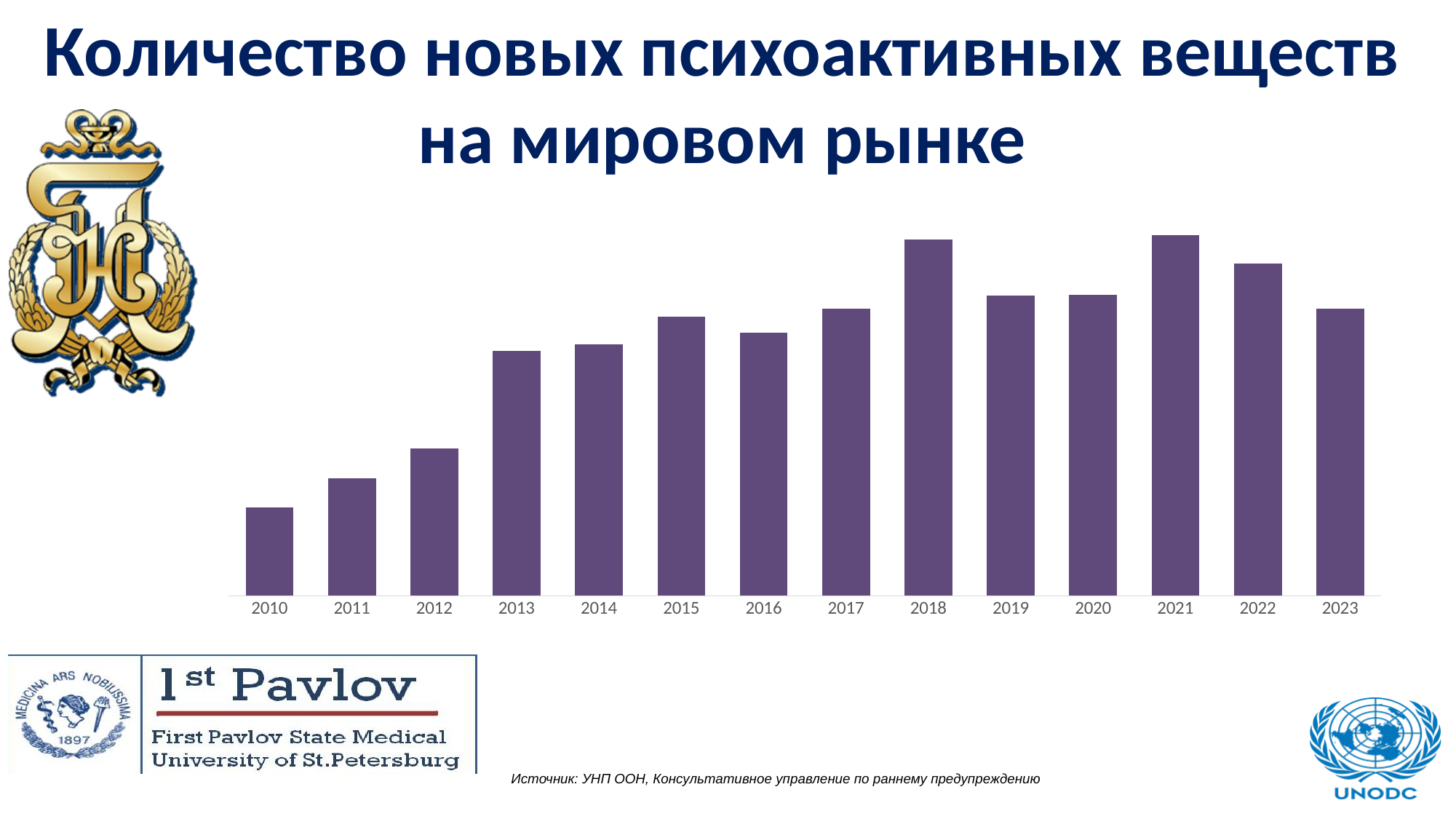
What is the title of the chart on the slide? Количество новых психоактивных веществ на мировом рынке Which year has the higher value, 2013 or 2016? 2016 Which year has the higher value, 2014 or 2015? 2015 Which year has the higher value, 2022 or 2023? 2022 How many years are shown on the x axis of the chart? 14 Do the values rise or fall from 2021 to 2023? Fall What colour are the bars in the chart? Purple What kind of chart is shown on the slide? Bar chart Which year has the lowest bar in the chart? 2010 Do the values rise or fall from 2010 to 2018? Rise